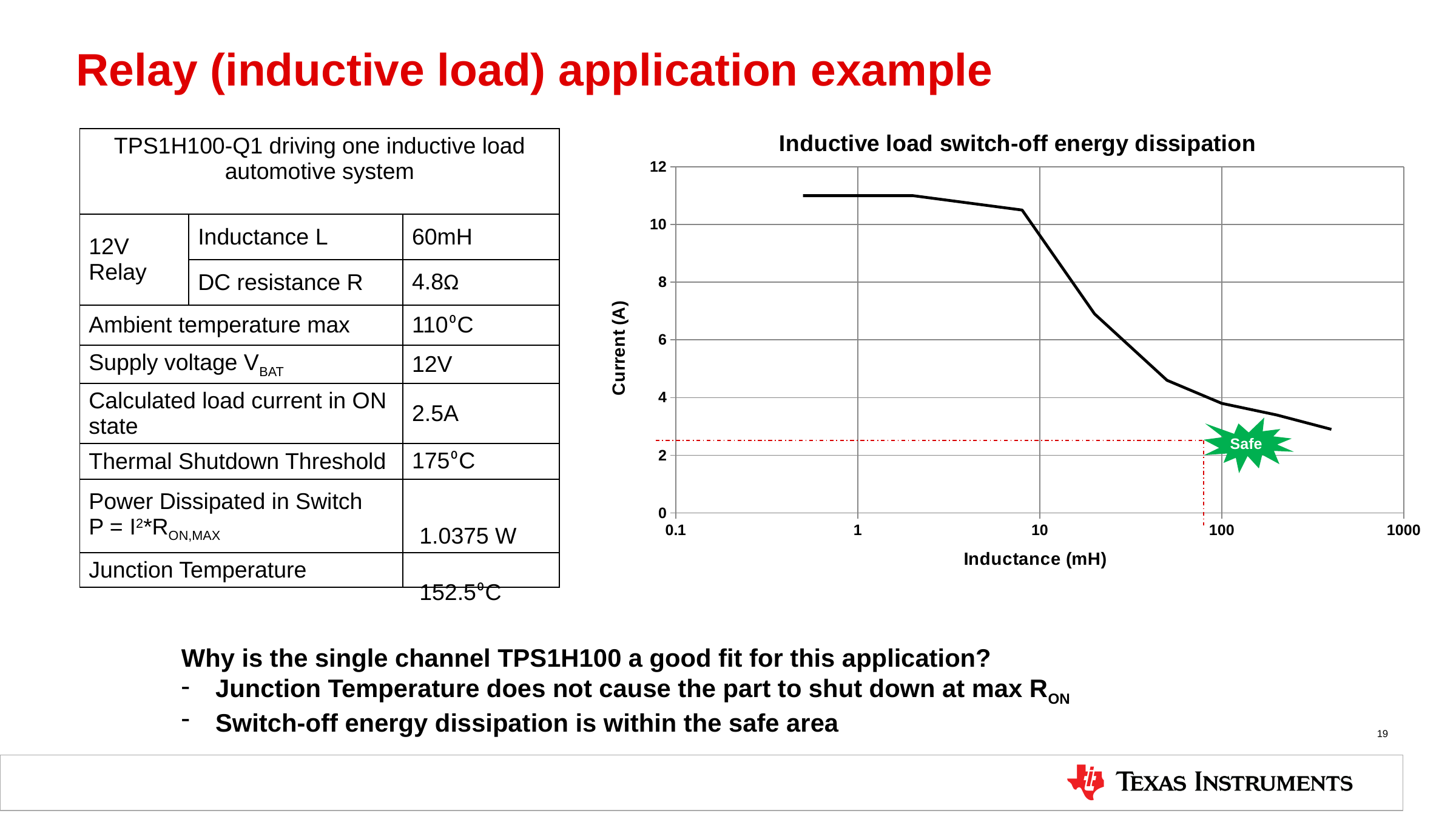
What is the label of the y axis of the chart? Current (A) Does the current rise or fall as inductance increases along the x axis? fall Is the current value at 100 mH inductance greater or less than 2 A? greater Is the current value at 10 mH inductance greater or less than 6 A? greater Is the current value at 100 mH inductance greater or less than 6 A? less Which has the higher current on the curve: 1 mH or 100 mH inductance? 1 mH What kind of chart is shown on the slide? line chart What is the title of the chart? Inductive load switch-off energy dissipation